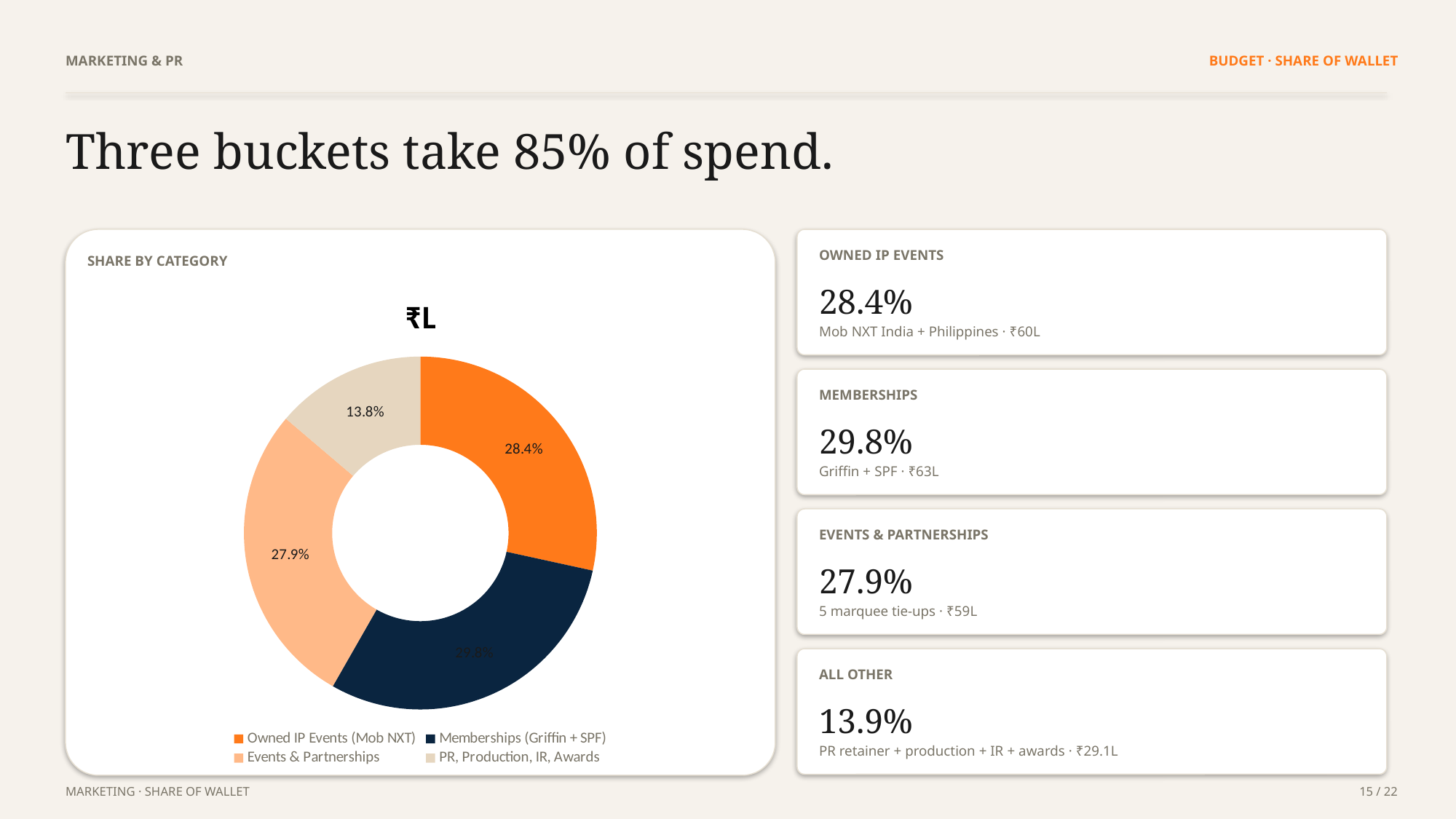
What share does the PR, Production, IR, Awards slice have in the pie chart? 13.8% What type of chart is shown on the slide? Pie chart (donut) How many slices does the pie chart have? 4 Which category has the smallest slice in the pie chart? PR, Production, IR, Awards Which category has the largest slice in the pie chart? Memberships (Griffin + SPF) Which slice is larger: Owned IP Events (Mob NXT) or PR, Production, IR, Awards? Owned IP Events (Mob NXT) What share does the Owned IP Events (Mob NXT) slice have in the pie chart? 28.4% What is the difference in percentage points between the Memberships (Griffin + SPF) slice and the PR, Production, IR, Awards slice? 16.0 percentage points What is the title shown above the pie chart? ₹L What colour is the Memberships (Griffin + SPF) slice in the pie chart? Dark navy What share does the Events & Partnerships slice have in the pie chart? 27.9% What share does the Memberships (Griffin + SPF) slice have in the pie chart? 29.8%